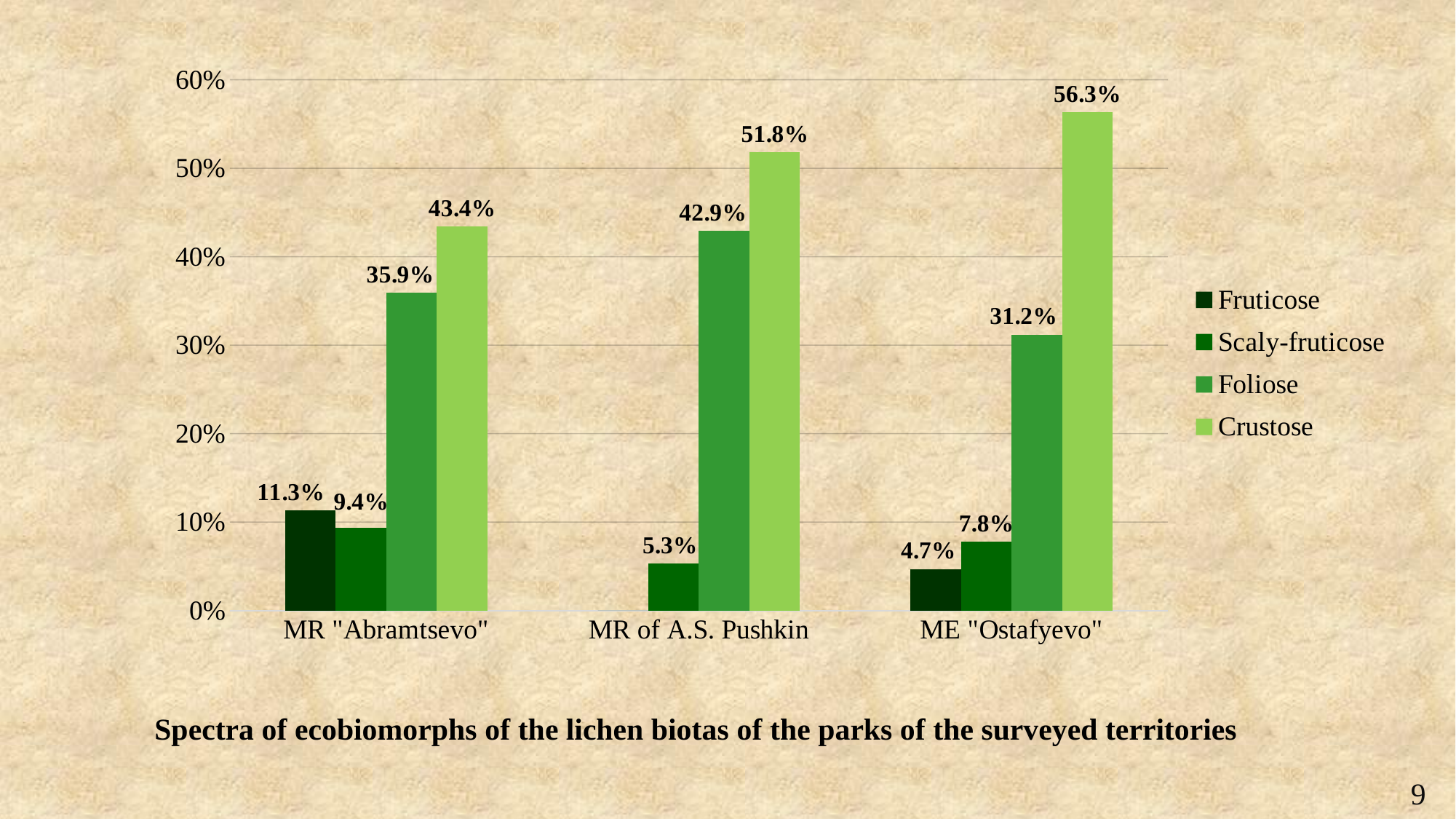
How much higher is the Crustose value for ME "Ostafyevo" than for MR "Abramtsevo"? 12.9% Which has the larger Foliose value, MR "Abramtsevo" or ME "Ostafyevo"? MR "Abramtsevo" How many territories are shown on the x axis? 3 Which territory has the lowest Scaly-fruticose value? MR of A.S. Pushkin Which territory has the highest Crustose value? ME "Ostafyevo" How many series does the legend list? 4 Is the Crustose value for MR of A.S. Pushkin greater or less than 50%? greater What is the Fruticose value for MR "Abramtsevo"? 11.3% What type of chart is shown on the slide? bar chart What is the Foliose value for MR of A.S. Pushkin? 42.9% What is the Scaly-fruticose value for ME "Ostafyevo"? 7.8% What is the Crustose value for ME "Ostafyevo"? 56.3%